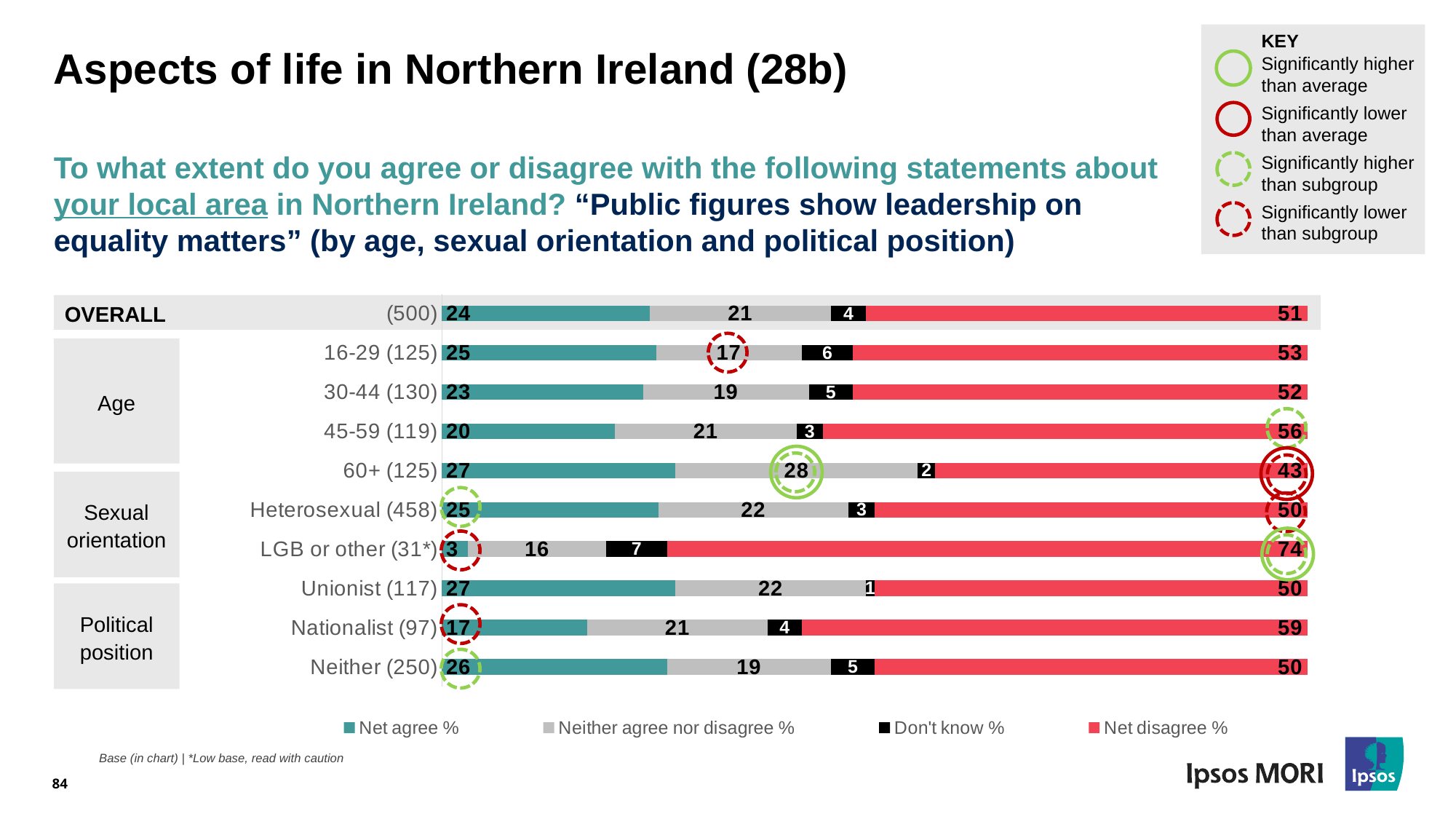
What is the difference between the Net disagree % values for Nationalist (97) and Unionist (117)? 9 What is the Don't know % value for Unionist (117)? 1 What is the Net disagree % value for LGB or other (31*)? 74 How many series does the legend list? 4 What kind of chart is shown on the slide? Stacked bar chart How many categories (bars) are shown in the chart? 10 What is the total of the stacked bar for 60+ (125)? 100 Which category has the highest Net disagree % value? LGB or other (31*) What is the Net agree % value for the OVERALL row? 24 Which category has the lowest Net agree % value? LGB or other (31*) Which has a higher Net agree % value, 16-29 (125) or 45-59 (119)? 16-29 (125) What is the Neither agree nor disagree % value for 60+ (125)? 28